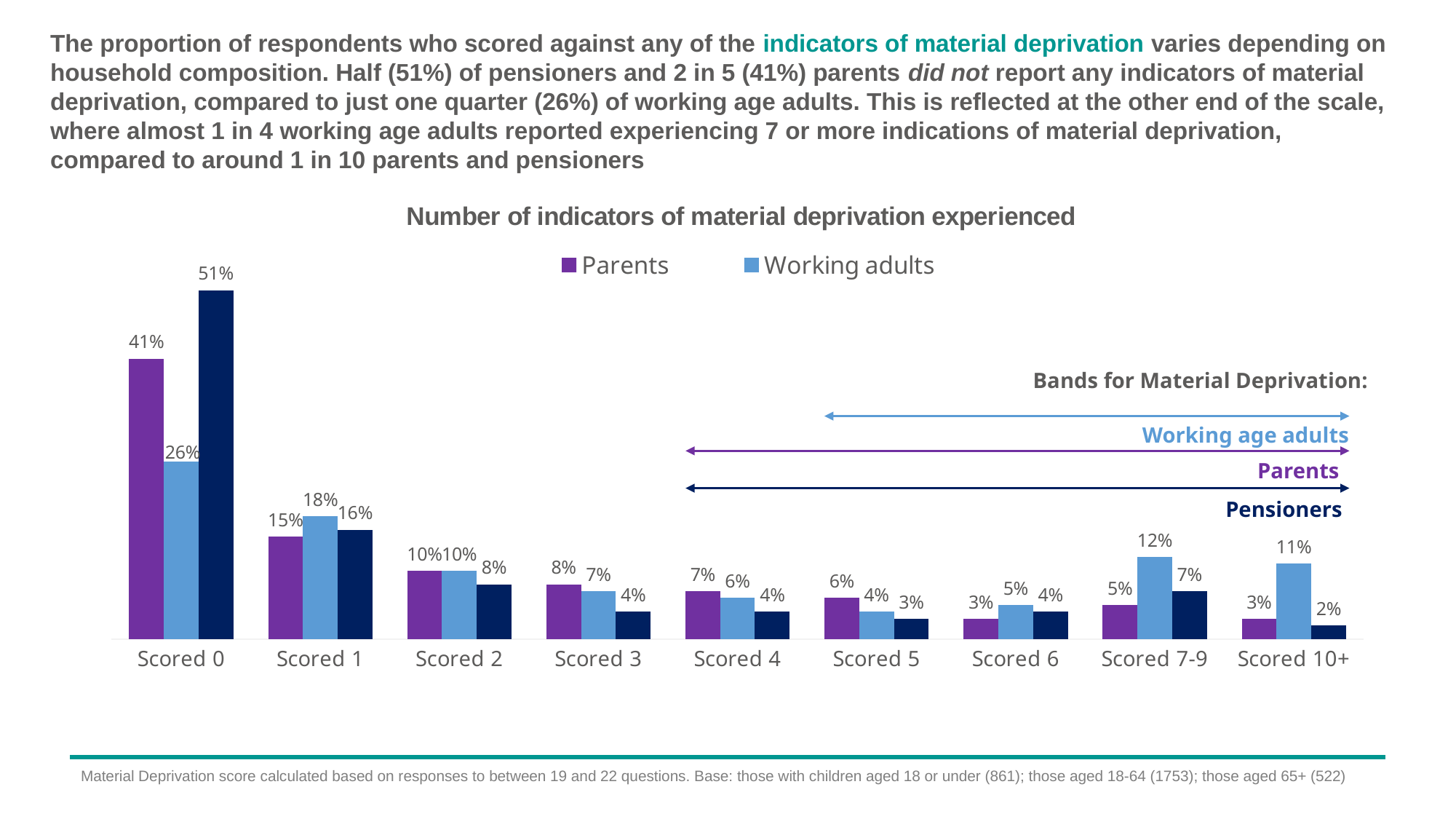
What is the difference between the Parents and Working adults values for Scored 0? 15% What is the value of the dark navy (Pensioners) bar for Scored 0? 51% Which is larger for Scored 7-9: the Parents value or the Working adults value? Working adults What is the value for Working adults in the Scored 7-9 category? 12% What is the value for Working adults in the Scored 10+ category? 11% What percentage of Parents scored 0 on the indicators of material deprivation? 41% How many series does the legend list? 2 Which category has the lowest value for the Working adults series? Scored 5 Which category has the highest value for the Parents series? Scored 0 How many score categories are shown on the x axis? 9 What is the title of the chart? Number of indicators of material deprivation experienced What type of chart is shown on the slide? Bar chart